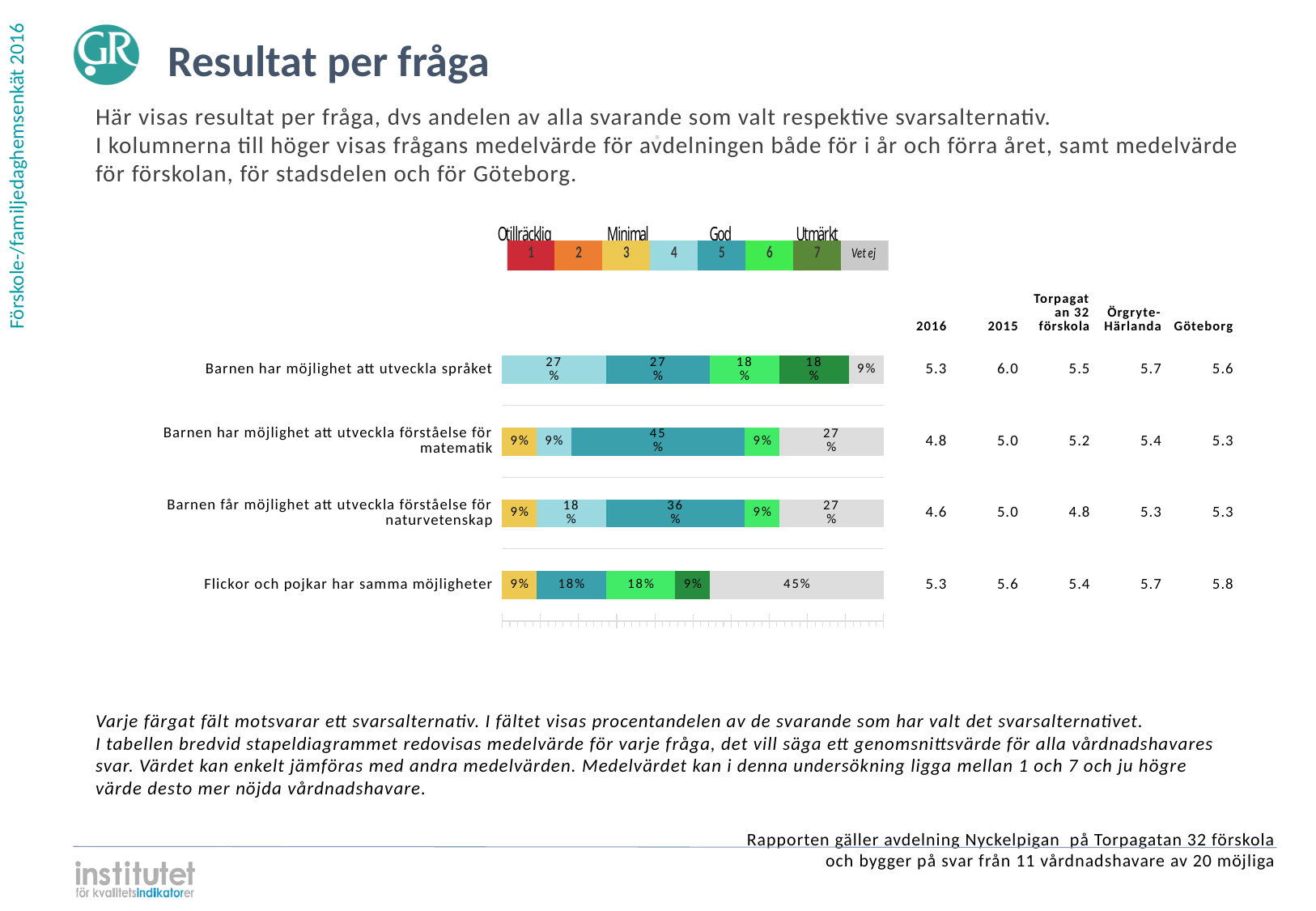
Which question has the smallest 'Vet ej' share? Barnen har möjlighet att utveckla språket What percentage of respondents chose 'Vet ej' for 'Flickor och pojkar har samma möjligheter'? 45% What is the difference between the answer-5 share for 'Barnen har möjlighet att utveckla förståelse för matematik' (45%) and for 'Barnen får möjlighet att utveckla förståelse för naturvetenskap' (36%)? 9% Which question has the largest 'Vet ej' share? Flickor och pojkar har samma möjligheter What percentage of respondents chose answer 4 for 'Barnen får möjlighet att utveckla förståelse för naturvetenskap'? 18% What percentage of respondents chose answer 5 for 'Barnen har möjlighet att utveckla förståelse för matematik'? 45% What kind of chart is shown on the slide? Stacked bar chart How many questions (bars) are shown in the chart? 4 What is the Göteborg mean value for 'Flickor och pojkar har samma möjligheter'? 5.8 What is the 2016 mean value for 'Barnen får möjlighet att utveckla förståelse för naturvetenskap'? 4.6 Which is larger: the answer-7 share for 'Barnen har möjlighet att utveckla språket' or for 'Flickor och pojkar har samma möjligheter'? Barnen har möjlighet att utveckla språket How many response categories does the legend above the chart list? 8